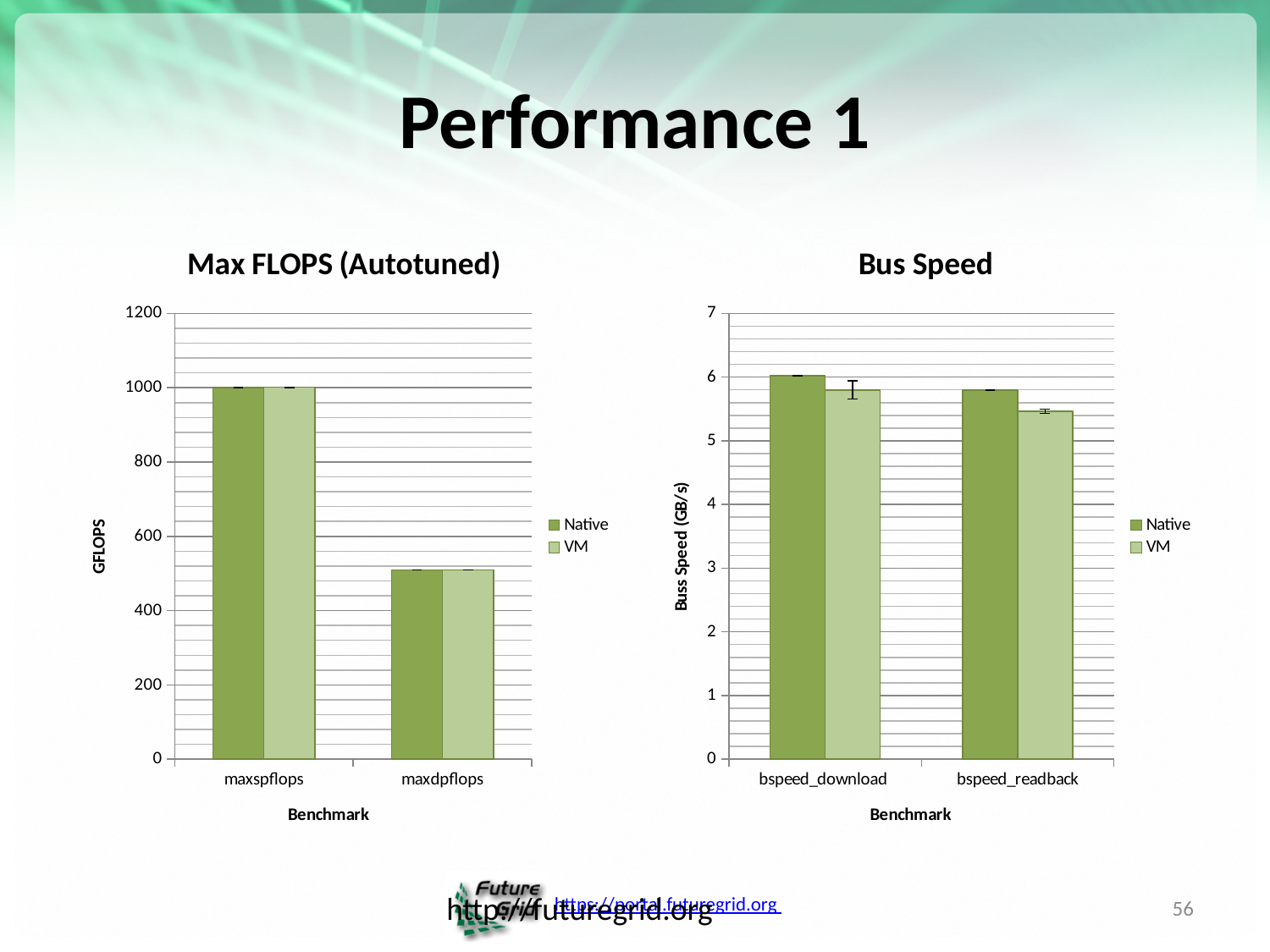
On the Bus Speed chart, what is the label of the x axis? Benchmark On the Bus Speed chart, is the Native value for bspeed_download greater or less than 5? greater On the Bus Speed chart, which benchmark has the lower VM value? bspeed_readback On the Bus Speed chart, how many series does the legend list? 2 On the Bus Speed chart, for bspeed_readback, which is larger: the Native value or the VM value? Native On the Max FLOPS (Autotuned) chart, what is the label of the y axis? GFLOPS On the Max FLOPS (Autotuned) chart, what kind of chart is shown? bar chart On the Bus Speed chart, is the VM value for bspeed_readback greater or less than 6? less On the Max FLOPS (Autotuned) chart, is the VM value for maxspflops greater or less than 800? greater On the Max FLOPS (Autotuned) chart, which benchmark has the higher Native value? maxspflops On the Max FLOPS (Autotuned) chart, how many benchmarks are shown on the x axis? 2